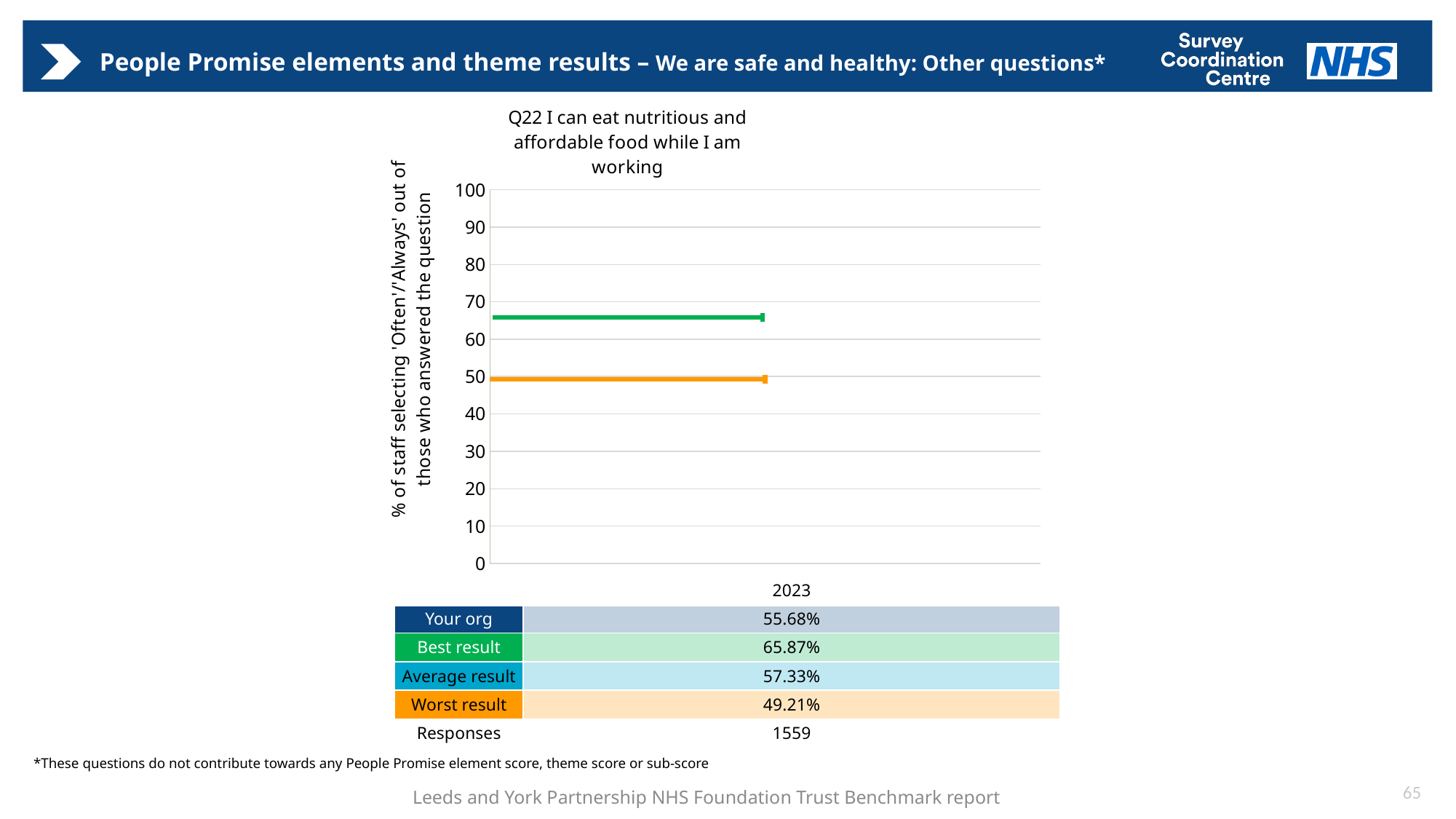
How many responses are recorded for 2023 in the Q22 chart? 1559 How many years are shown on the x axis of the Q22 chart? 1 What is the Your org value for 2023 in the Q22 chart? 55.68% What is the difference between the Best result and the Worst result for 2023? 16.66% What is the Best result value for 2023 in the Q22 chart? 65.87% Is the green Best result line plotted greater or less than 60 on the y axis? greater Which is larger for 2023: the Your org value or the Average result? Average result What is the title of the chart on the slide? Q22 I can eat nutritious and affordable food while I am working What is the Average result value for 2023 in the Q22 chart? 57.33% What is the difference between the Average result and the Your org value for 2023? 1.65% What is the Worst result value for 2023 in the Q22 chart? 49.21%